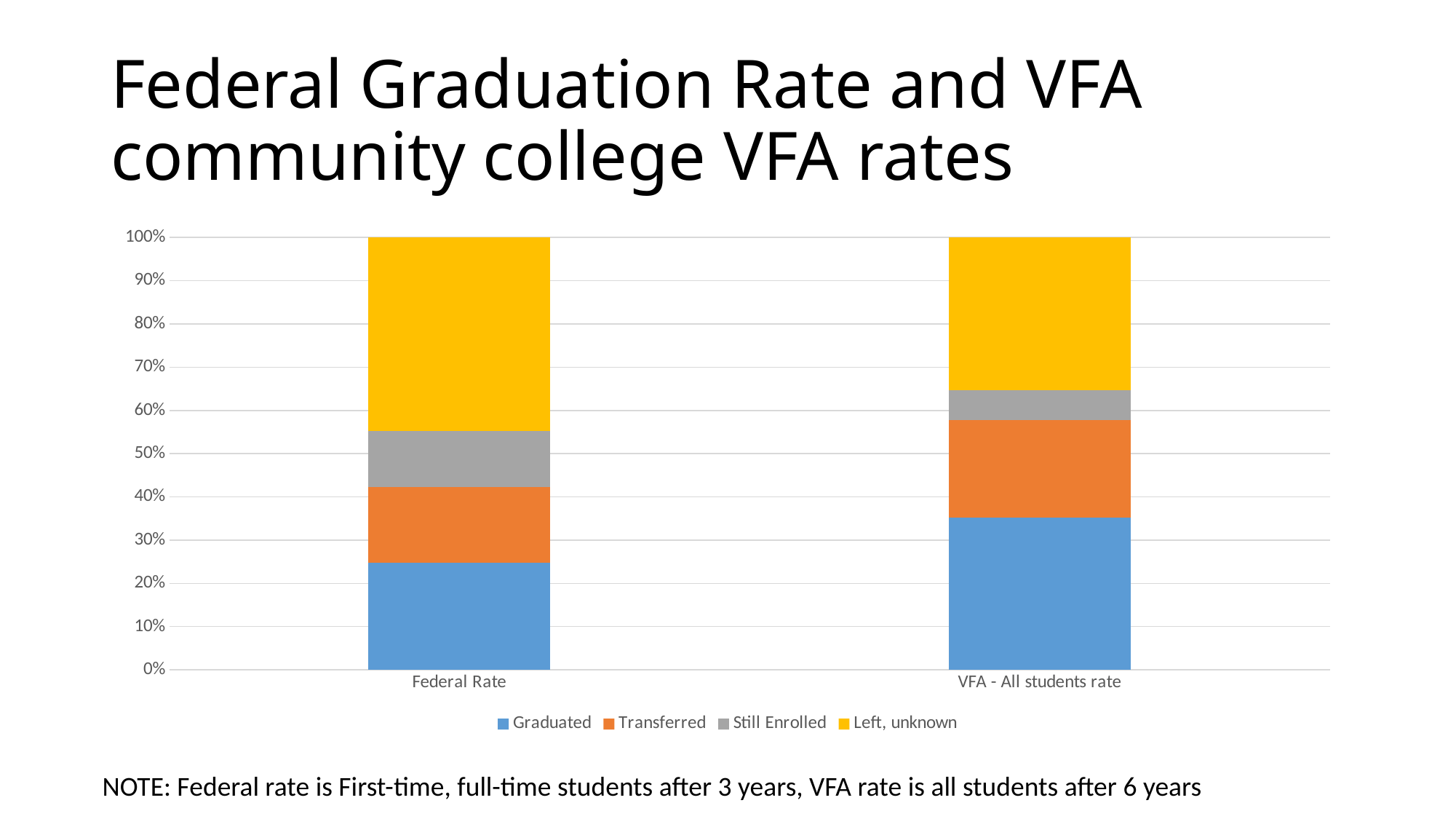
What is the total height of the Federal Rate stacked bar? 100% Is the Left, unknown share for Federal Rate greater or less than 40%? greater Which category has the larger Graduated share, Federal Rate or VFA - All students rate? VFA - All students rate Is the Graduated value for Federal Rate greater or less than 30%? less How many categories are plotted along the x axis? 2 What are the series names listed in the legend? Graduated, Transferred, Still Enrolled, Left, unknown Which category has the larger Left, unknown share, Federal Rate or VFA - All students rate? Federal Rate Is the Graduated value for VFA - All students rate greater or less than 30%? greater How many series does the legend list? 4 What kind of chart is shown on the slide? Stacked bar chart Which colour represents the Transferred series in the chart? Orange